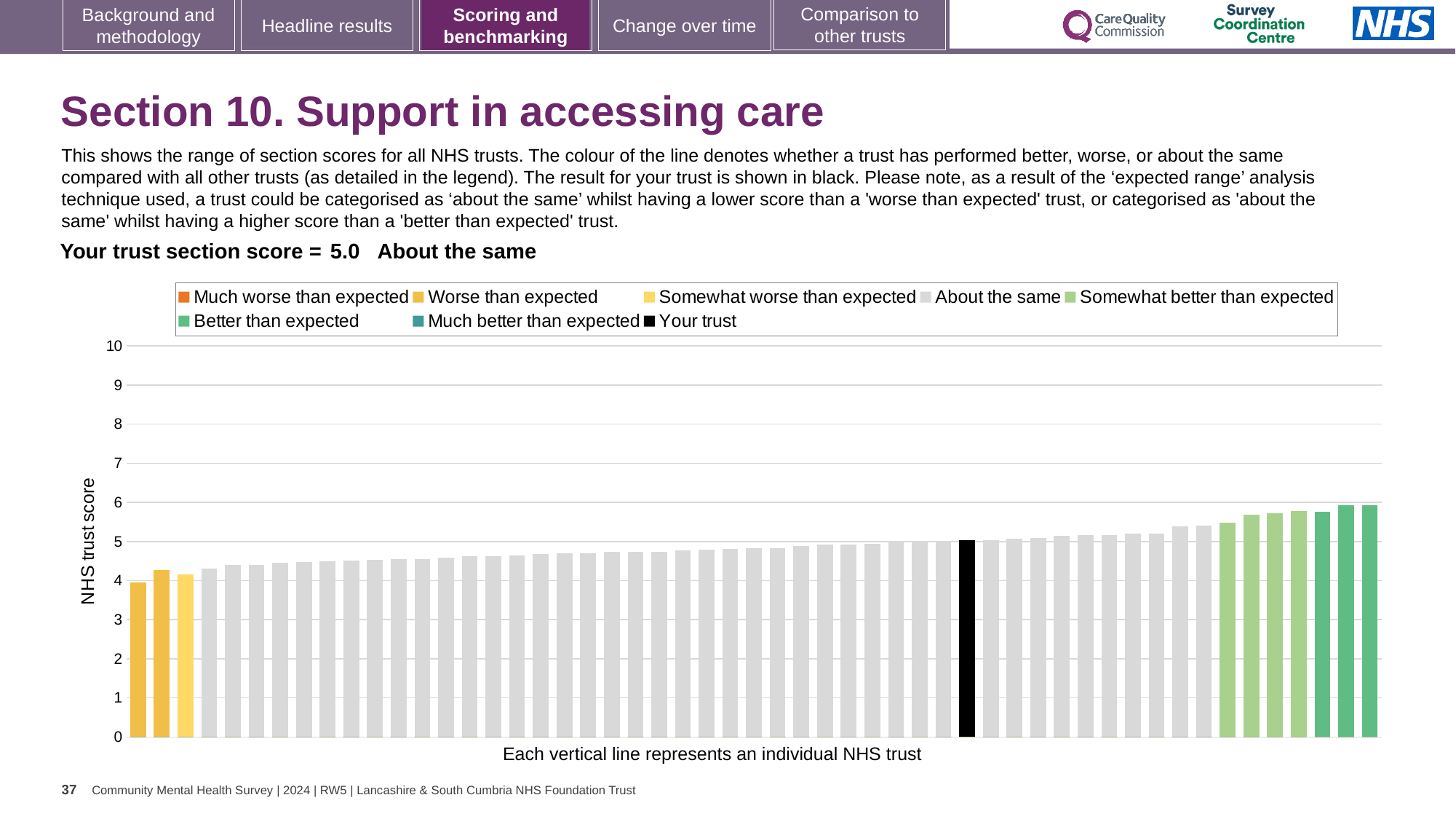
What kind of chart is shown on the slide? bar chart What is the section score for your trust shown on the slide? 5.0 Is the value of the shortest bar greater or less than 3? greater What is the label of the y axis? NHS trust score How many entries does the chart legend list? 8 Is the value of the tallest bar greater or less than 7? less Do the bar values rise or fall from left to right along the x axis? rise Which category is your trust placed in according to the slide? About the same Is the value of the shortest bar greater or less than 5? less What is the highest value shown on the y axis? 10